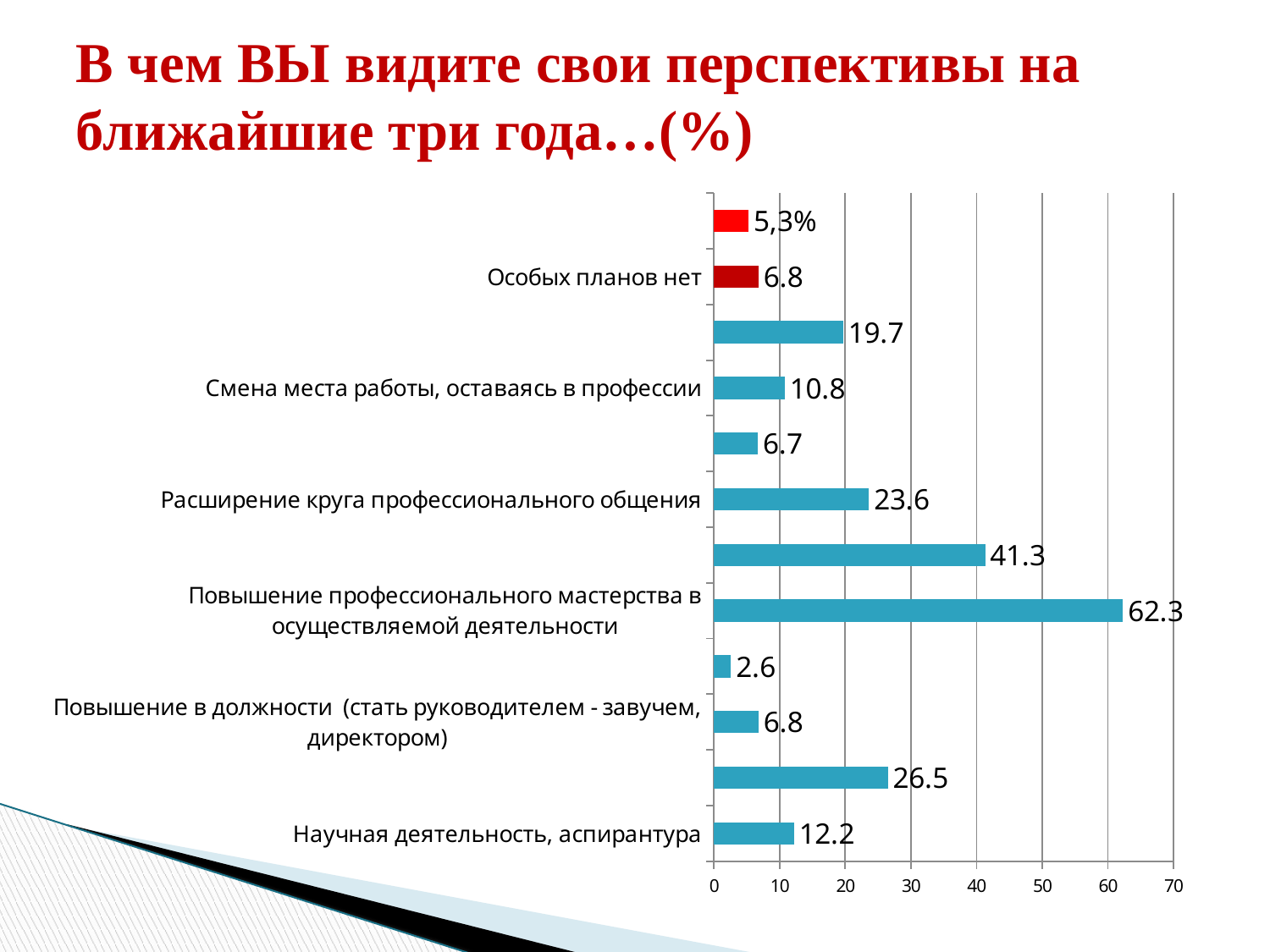
What is the value for "Особых планов нет"? 6.8 What is the smallest value shown on any bar in the chart? 2.6 Which is larger: the value for "Научная деятельность, аспирантура" or the value for "Смена места работы, оставаясь в профессии"? Научная деятельность, аспирантура What is the value for "Расширение круга профессионального общения"? 23.6 Which category has the highest value in the chart? Повышение профессионального мастерства в осуществляемой деятельности What is the maximum value shown on the horizontal axis of the chart? 70 What is the value for "Повышение профессионального мастерства в осуществляемой деятельности"? 62.3 What is the value for "Смена места работы, оставаясь в профессии"? 10.8 What is the difference between the values for "Повышение профессионального мастерства в осуществляемой деятельности" and "Расширение круга профессионального общения"? 38.7 How many bars are plotted in the chart? 12 What kind of chart is shown on the slide? bar chart What is the value for "Научная деятельность, аспирантура"? 12.2